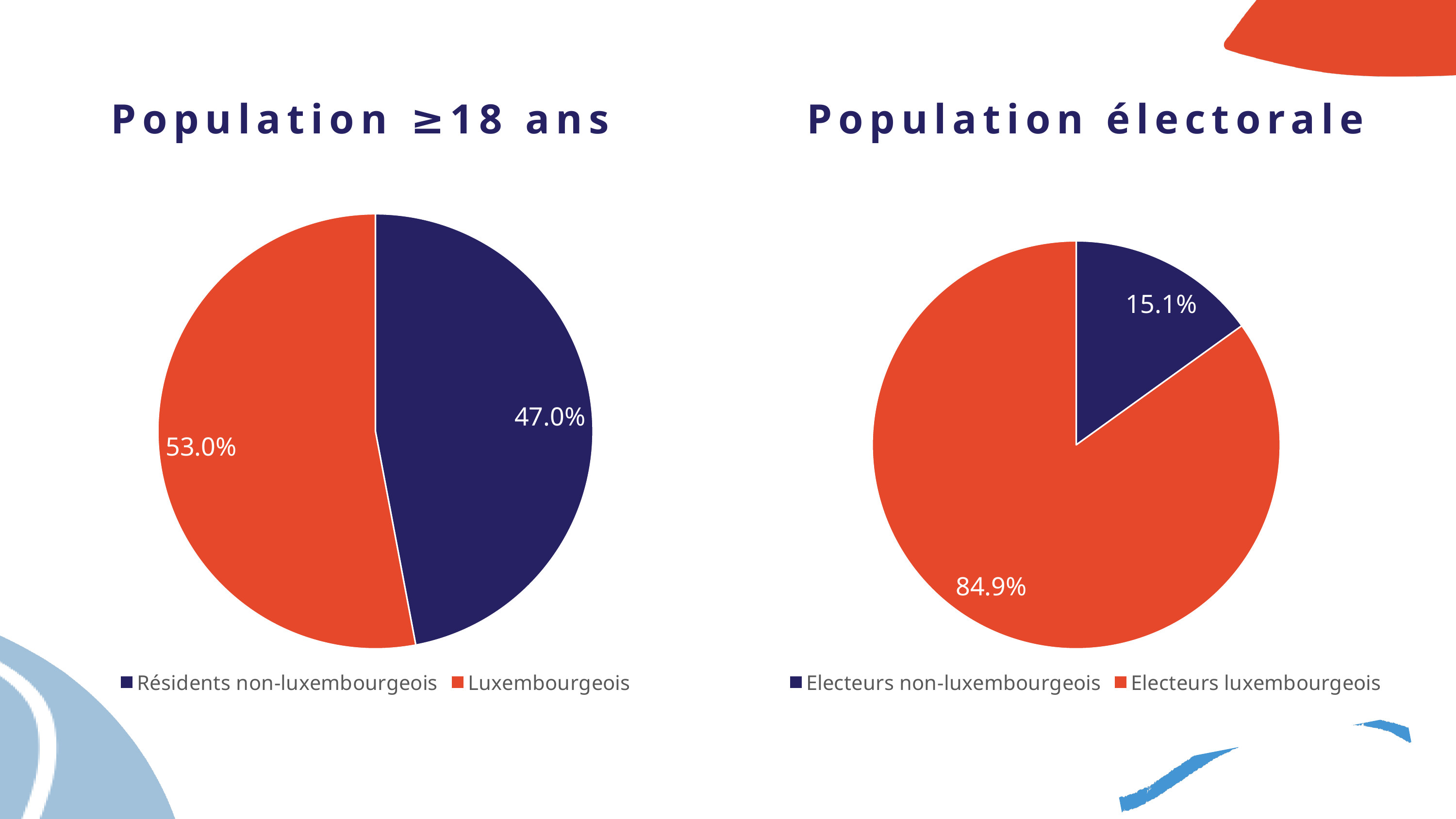
Which is larger: the non-Luxembourgish share in the 'Population ≥18 ans' chart or in the 'Population électorale' chart? Population ≥18 ans In the 'Population électorale' chart, what share is labelled for Electeurs luxembourgeois? 84.9% In the 'Population électorale' chart, what colour is the Electeurs luxembourgeois slice? Orange-red How many slices does the 'Population électorale' chart have? 2 What type of chart is used on the left of the slide, titled 'Population ≥18 ans'? Pie chart In the 'Population ≥18 ans' chart, what share is labelled for Luxembourgeois? 53.0% In the 'Population ≥18 ans' chart, what share is labelled for Résidents non-luxembourgeois? 47.0% In the 'Population ≥18 ans' chart, which slice is the largest? Luxembourgeois In the 'Population électorale' chart, what share is labelled for Electeurs non-luxembourgeois? 15.1% In the 'Population électorale' chart, which slice is the smallest? Electeurs non-luxembourgeois In the 'Population ≥18 ans' chart, what is the difference between the Luxembourgeois and Résidents non-luxembourgeois shares? 6.0% In the 'Population électorale' chart, what is the difference between the Electeurs luxembourgeois and Electeurs non-luxembourgeois shares? 69.8%